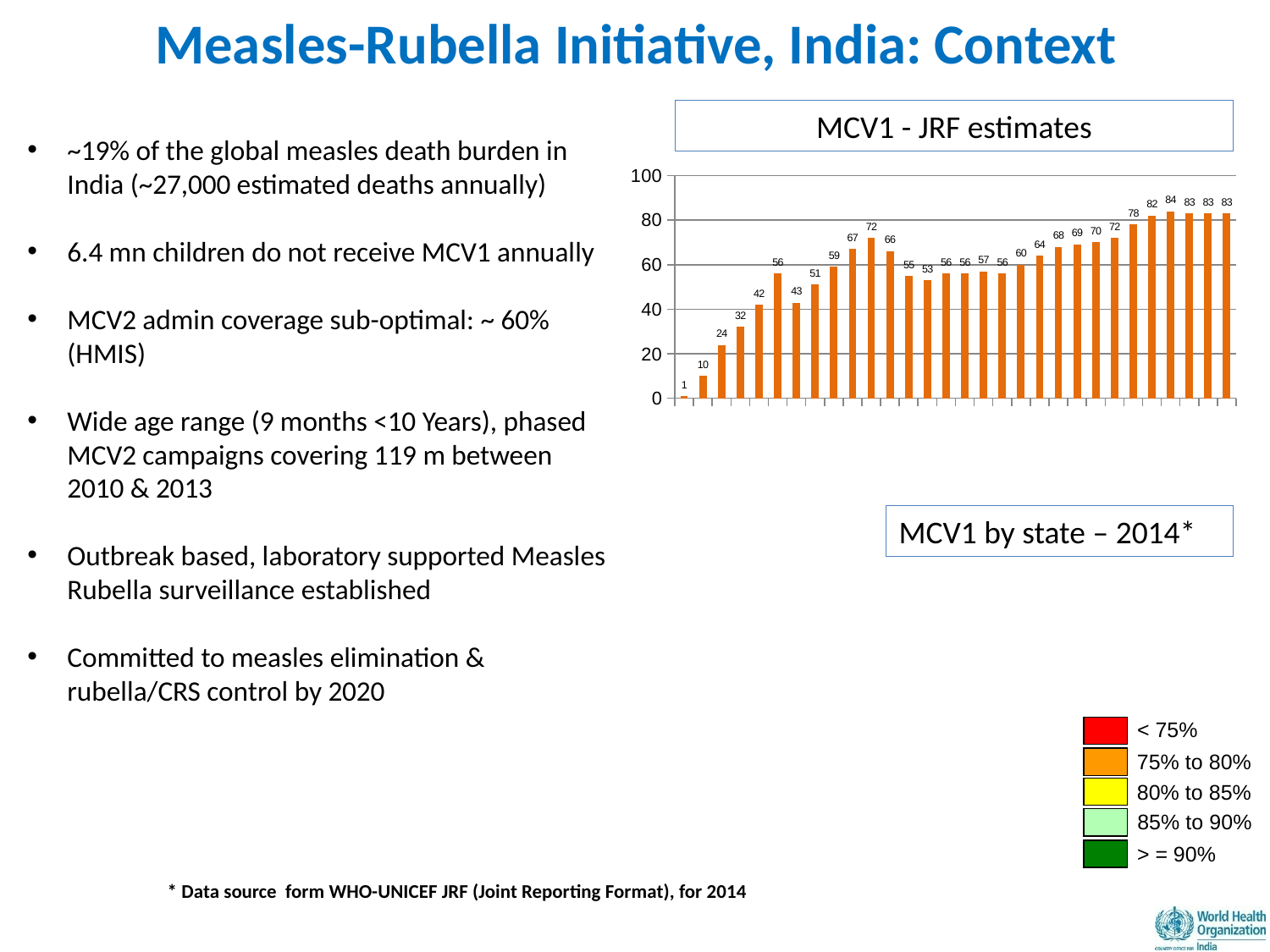
In the 'MCV1 - JRF estimates' chart, what is the difference between the last bar (83) and the first bar (1)? 82 In the 'MCV1 - JRF estimates' chart, what is the value of the last (rightmost) bar? 83 In the 'MCV1 - JRF estimates' chart, do the values generally rise or fall from left to right along the x axis? rise In the 'MCV1 - JRF estimates' chart, what is the value of the first (leftmost) bar? 1 What kind of chart is the 'MCV1 - JRF estimates' chart? bar chart In the 'MCV1 - JRF estimates' chart, what is the highest value shown on any bar? 84 In the 'MCV1 - JRF estimates' chart, what is the lowest value shown on any bar? 1 In the 'MCV1 - JRF estimates' chart, how many bars are plotted? 30 What is the maximum value shown on the y axis of the 'MCV1 - JRF estimates' chart? 100 In the 'MCV1 - JRF estimates' chart, what is the difference between the highest bar value (84) and the lowest bar value (1)? 83 In the 'MCV1 - JRF estimates' chart, which is larger: the first bar or the last bar? the last bar In the 'MCV1 - JRF estimates' chart, is the value of the second bar from the left greater or less than 20? less